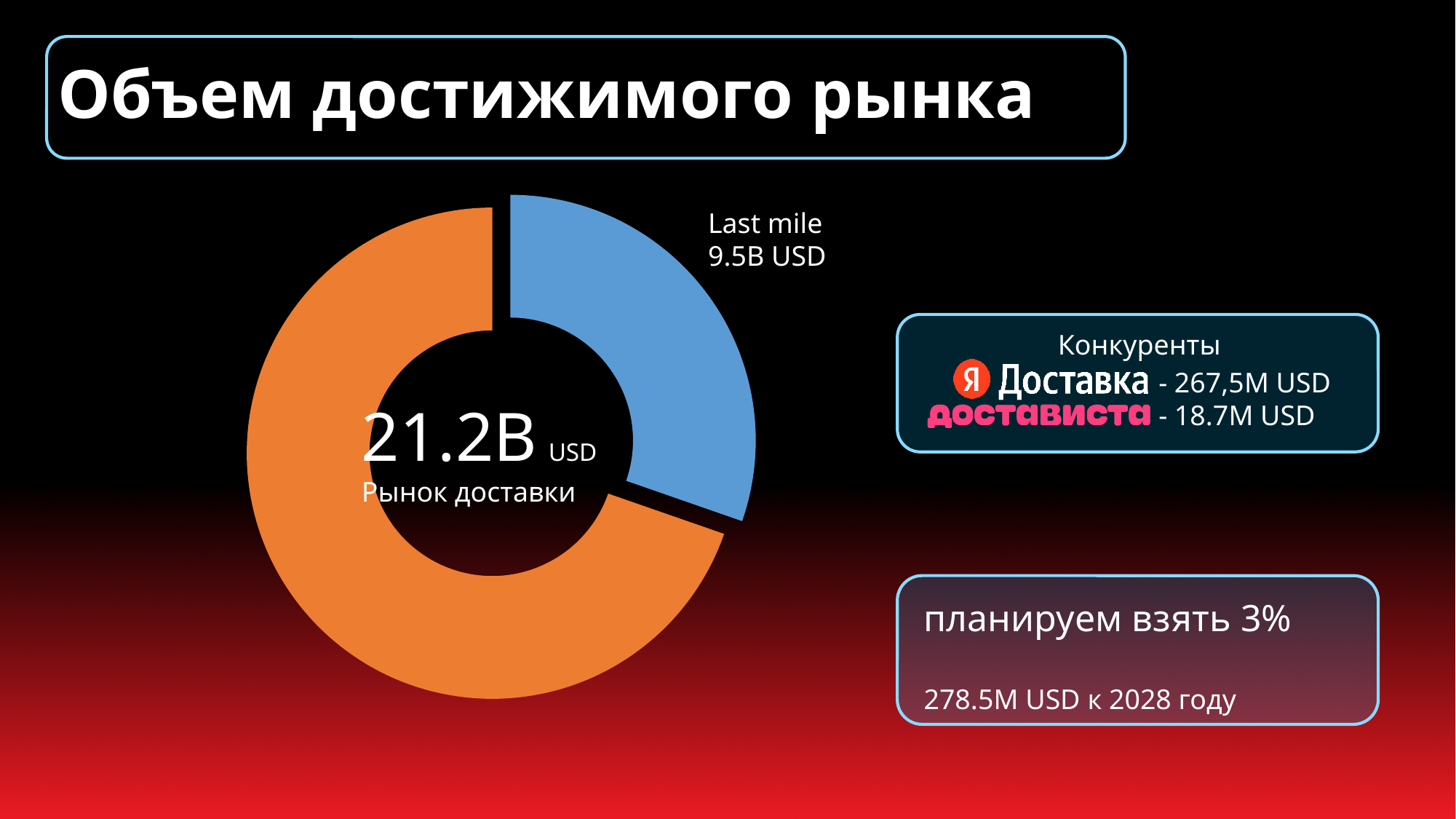
Does the Last mile slice take up more or less than half of the chart? less What value is shown for the Last mile slice? 9.5B USD What label is printed under the value in the centre of the donut chart? Рынок доставки Is the Last mile slice larger or smaller than the orange slice? smaller What total value is printed in the centre of the donut chart? 21.2B USD How many slices does the donut chart have? 2 What kind of chart is shown on the slide? pie (donut) chart What colour is the Last mile slice? blue